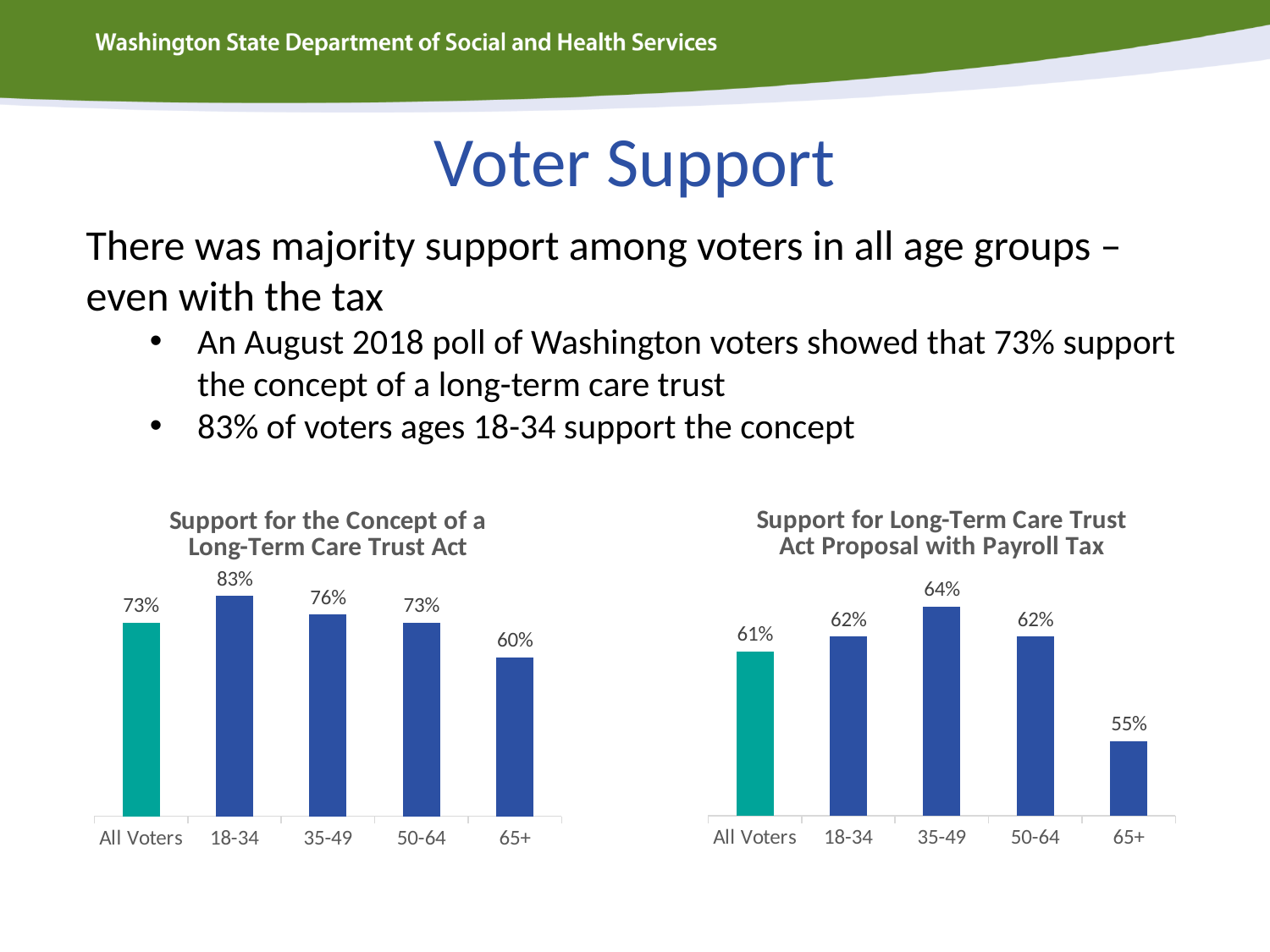
What kind of chart is the 'Support for the Concept of a Long-Term Care Trust Act' chart? Bar chart In the 'Support for Long-Term Care Trust Act Proposal with Payroll Tax' chart, what is the difference between the 35-49 and 65+ values? 9% In the 'Support for the Concept of a Long-Term Care Trust Act' chart, which is larger: the value for 35-49 or the value for 50-64? 35-49 In the 'Support for Long-Term Care Trust Act Proposal with Payroll Tax' chart, what is the value for All Voters? 61% In the 'Support for the Concept of a Long-Term Care Trust Act' chart, which category has the lowest value? 65+ How many categories are shown in the 'Support for Long-Term Care Trust Act Proposal with Payroll Tax' chart? 5 In the 'Support for Long-Term Care Trust Act Proposal with Payroll Tax' chart, which category has the highest value? 35-49 In the 'Support for the Concept of a Long-Term Care Trust Act' chart, what is the difference between the 18-34 and 65+ values? 23% In the 'Support for the Concept of a Long-Term Care Trust Act' chart, do the values rise or fall across the age groups from 18-34 to 65+? Fall In the 'Support for Long-Term Care Trust Act Proposal with Payroll Tax' chart, what is the value for the 50-64 age group? 62% In the 'Support for the Concept of a Long-Term Care Trust Act' chart, what is the value for the 18-34 age group? 83% In the 'Support for the Concept of a Long-Term Care Trust Act' chart, which bar is coloured differently from the others? All Voters